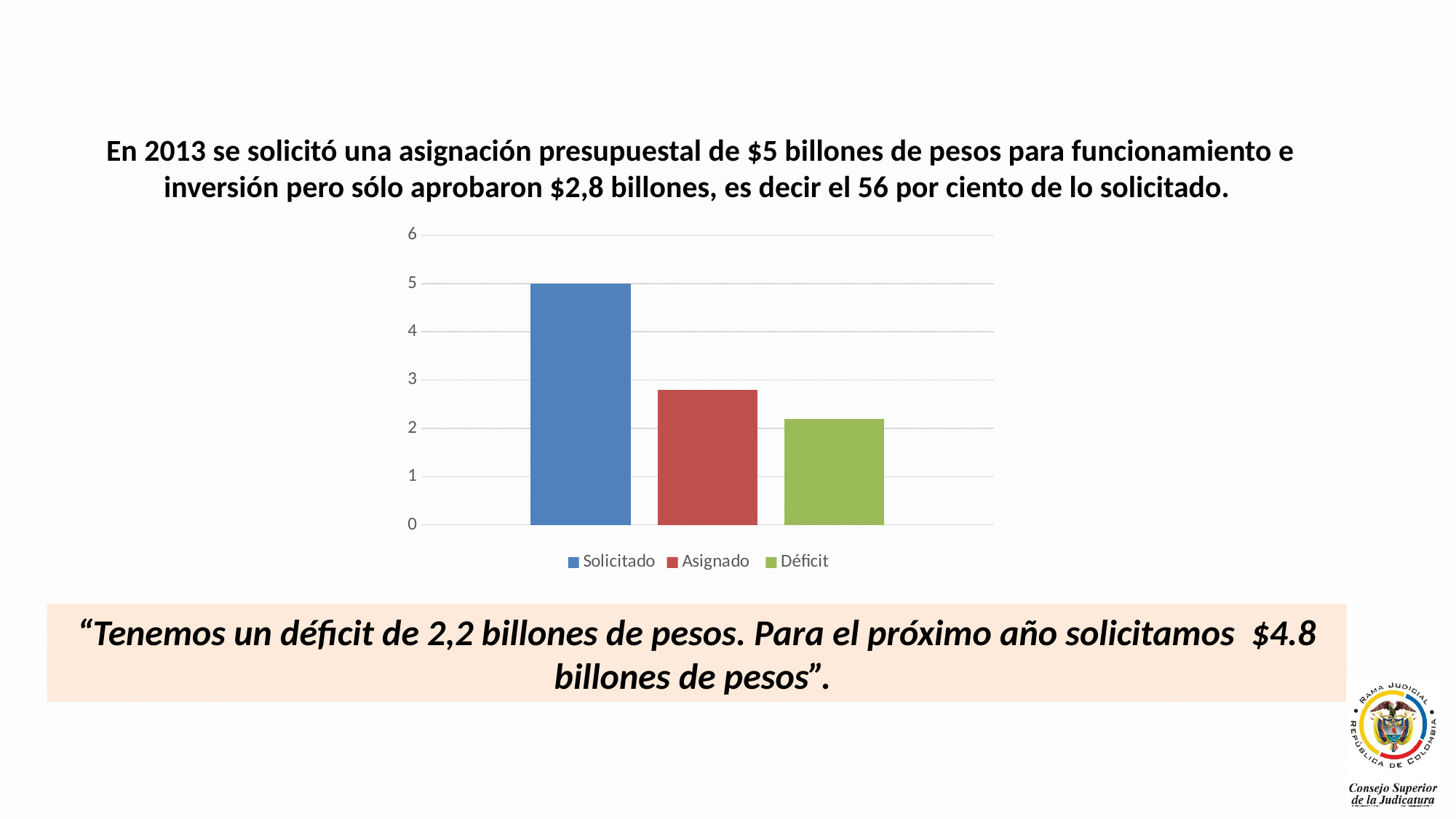
What kind of chart is shown on the slide? Bar chart Which series has the highest bar in the chart? Solicitado Which is larger, the Asignado bar or the Déficit bar? Asignado What is the value of the Solicitado bar? 5 How many series does the chart legend list? 3 How many bars are plotted in the chart? 3 Is the value for Déficit greater or less than 2? greater What colour is the Solicitado bar? Blue Which series has the lowest bar in the chart? Déficit What are the three entries listed in the chart legend? Solicitado, Asignado, Déficit Is the value for Asignado greater or less than 2? greater Is the value for Asignado greater or less than 3? less